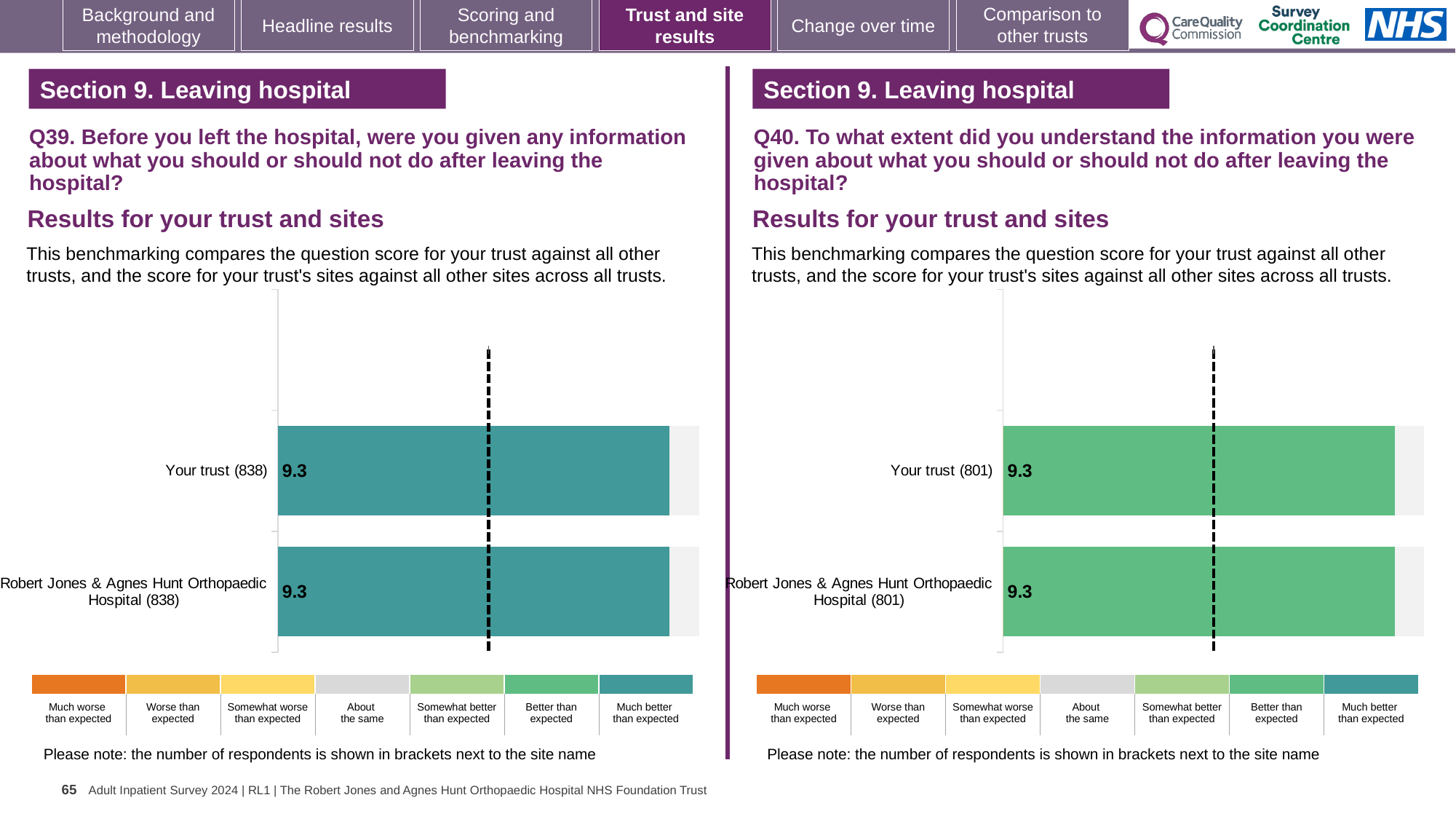
On the right chart (Q40), what is the difference between the score for Your trust and the score for Robert Jones & Agnes Hunt Orthopaedic Hospital? 0.0 How many bars are plotted on the right chart (Q40)? 2 On the left chart (Q39), how many respondents are shown in brackets for Your trust? 838 On the left chart (Q39), what is the score for Robert Jones & Agnes Hunt Orthopaedic Hospital? 9.3 On the right chart (Q40), what is the score for Robert Jones & Agnes Hunt Orthopaedic Hospital? 9.3 How many bars are plotted on the left chart (Q39)? 2 On the right chart (Q40), which benchmark category does the colour of the bars correspond to in the legend? Better than expected What kind of chart is used on the left (Q39)? Bar chart On the left chart (Q39), what is the difference between the score for Your trust and the score for Robert Jones & Agnes Hunt Orthopaedic Hospital? 0.0 On the right chart (Q40), what is the score for Your trust? 9.3 On the right chart (Q40), how many respondents are shown in brackets for Your trust? 801 On the left chart (Q39), what is the score for Your trust? 9.3